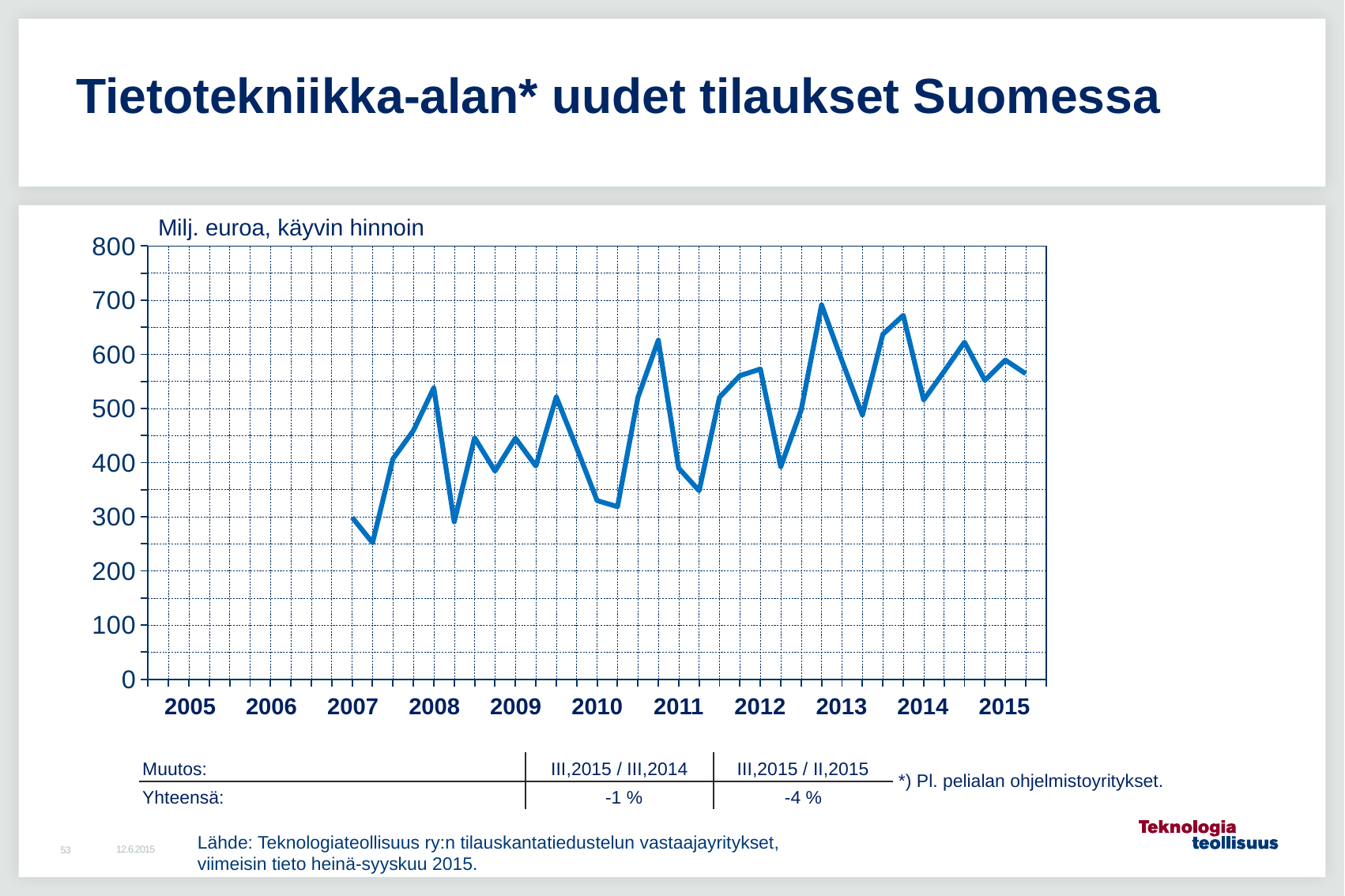
What unit label is shown above the y axis of the chart? Milj. euroa, käyvin hinnoin What is the title of the chart on the slide? Tietotekniikka-alan* uudet tilaukset Suomessa In which year does the plotted line reach its lowest point? 2007 Is the highest point of the line greater or less than 600? greater What is the highest value shown on the y axis of the chart? 800 Is the lowest point of the line greater or less than 300? less What kind of chart is shown on the slide? line chart Are the values in 2015 higher or lower than the values in 2007? higher In which year does the plotted line reach its highest point? 2013 How many data series are plotted in the chart? 1 Overall, do the values rise or fall from 2007 to 2015? rise